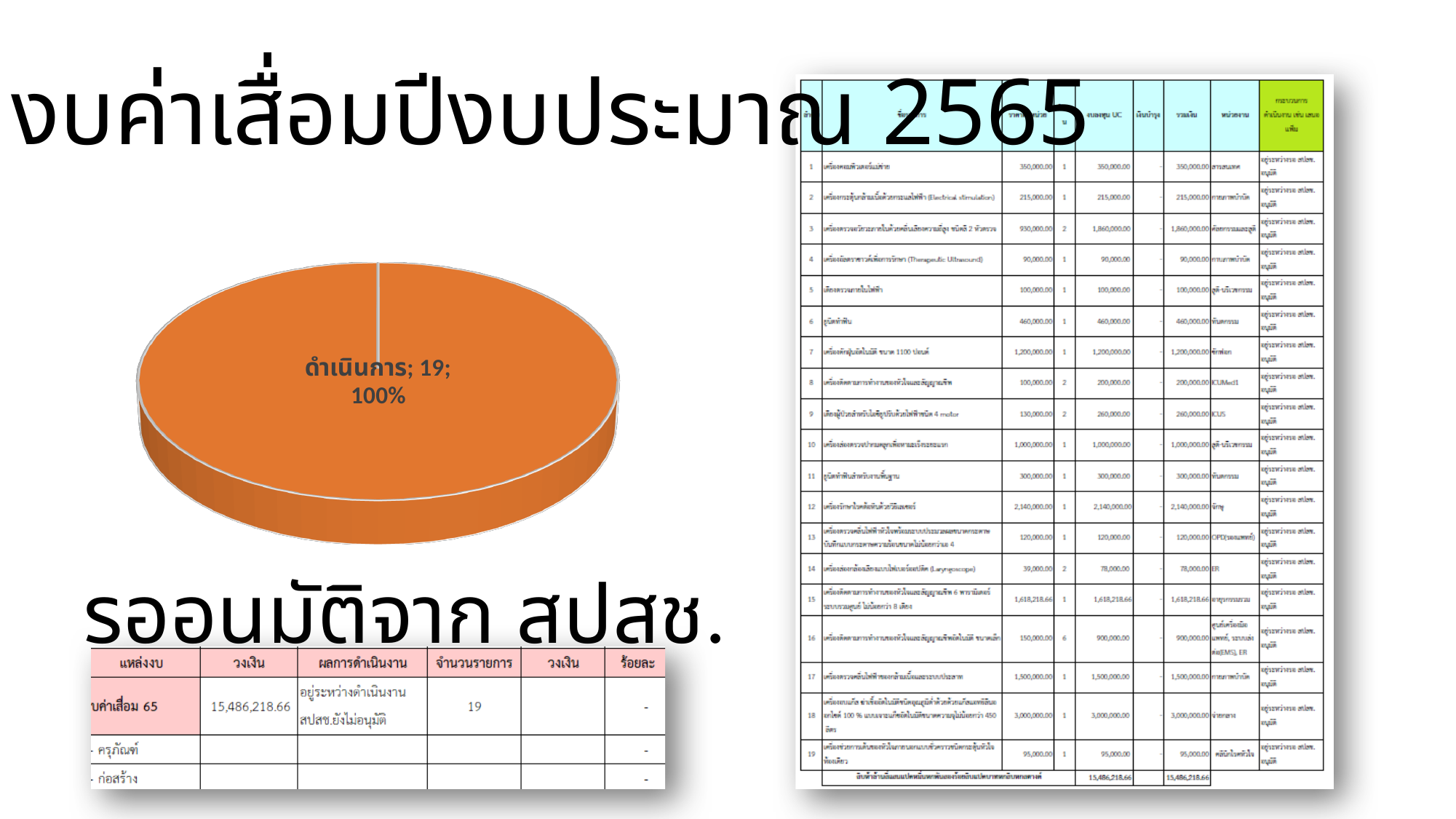
How many slices does the pie chart have? 1 What share of the pie does the ดำเนินการ slice represent? 100% Is the value shown for the ดำเนินการ slice greater or less than 10? greater What kind of chart is shown on the left of the slide? pie chart What value is printed on the pie chart slice labelled ดำเนินการ? 19 What colour is the slice in the pie chart? orange What is the label of the only slice in the pie chart? ดำเนินการ